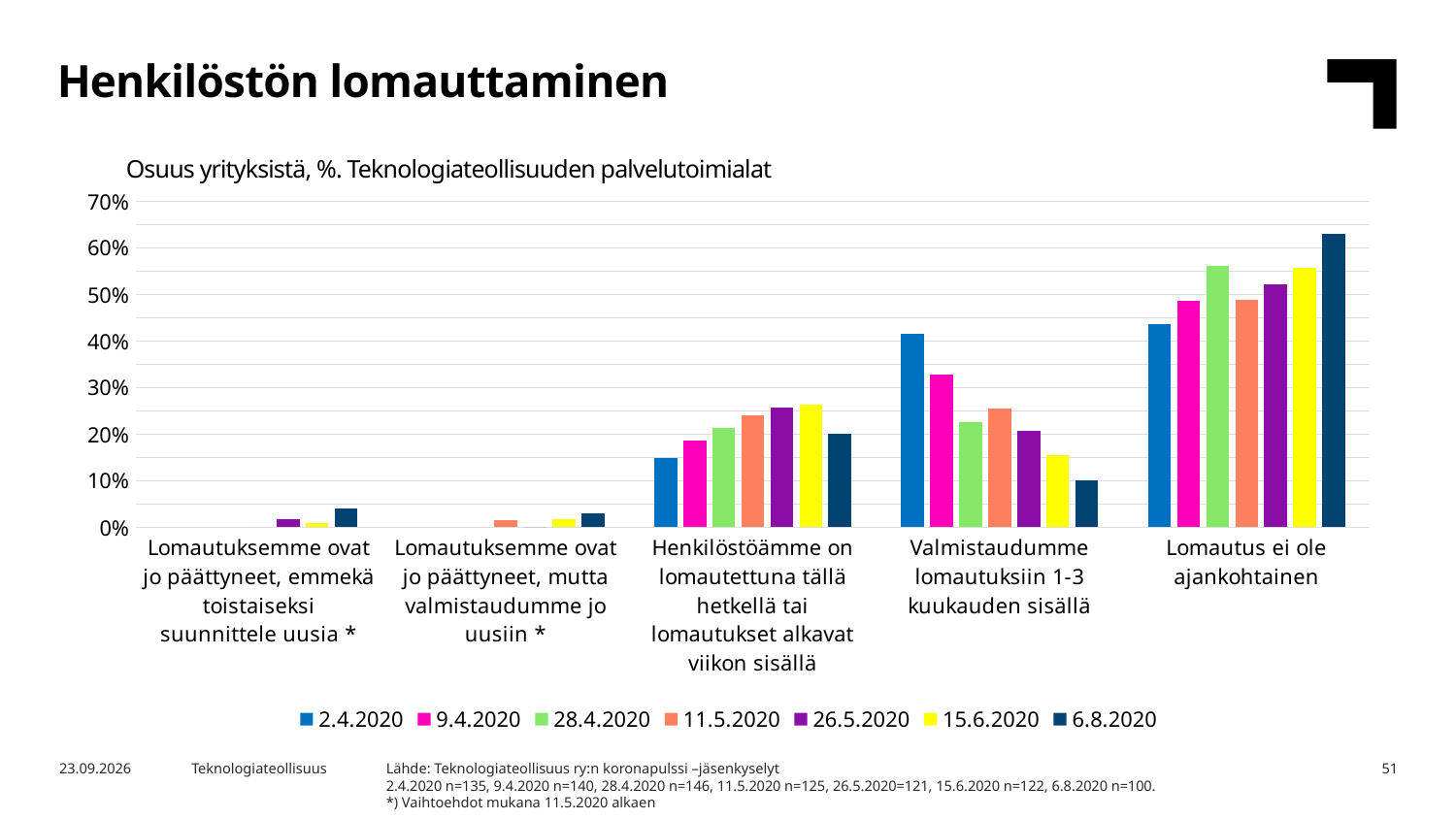
For 'Valmistaudumme lomautuksiin 1-3 kuukauden sisällä', which is larger: the 2.4.2020 value or the 6.8.2020 value? 2.4.2020 Is the 2.4.2020 value for 'Valmistaudumme lomautuksiin 1-3 kuukauden sisällä' greater or less than 40%? greater What kind of chart is shown on the slide? Bar chart Is the 2.4.2020 value for 'Henkilöstöämme on lomautettuna tällä hetkellä tai lomautukset alkavat viikon sisällä' greater or less than 20%? less How many categories are shown on the x axis of the chart? 5 Do the values for 'Valmistaudumme lomautuksiin 1-3 kuukauden sisällä' rise or fall across the survey dates from 2.4.2020 to 6.8.2020? fall How many series does the legend list? 7 What is the title of the slide? Henkilöstön lomauttaminen Which series has the lowest bar in the 'Valmistaudumme lomautuksiin 1-3 kuukauden sisällä' category? 6.8.2020 Is the 6.8.2020 value for 'Valmistaudumme lomautuksiin 1-3 kuukauden sisällä' greater or less than 20%? less Which category has the highest bar for the 6.8.2020 series? Lomautus ei ole ajankohtainen